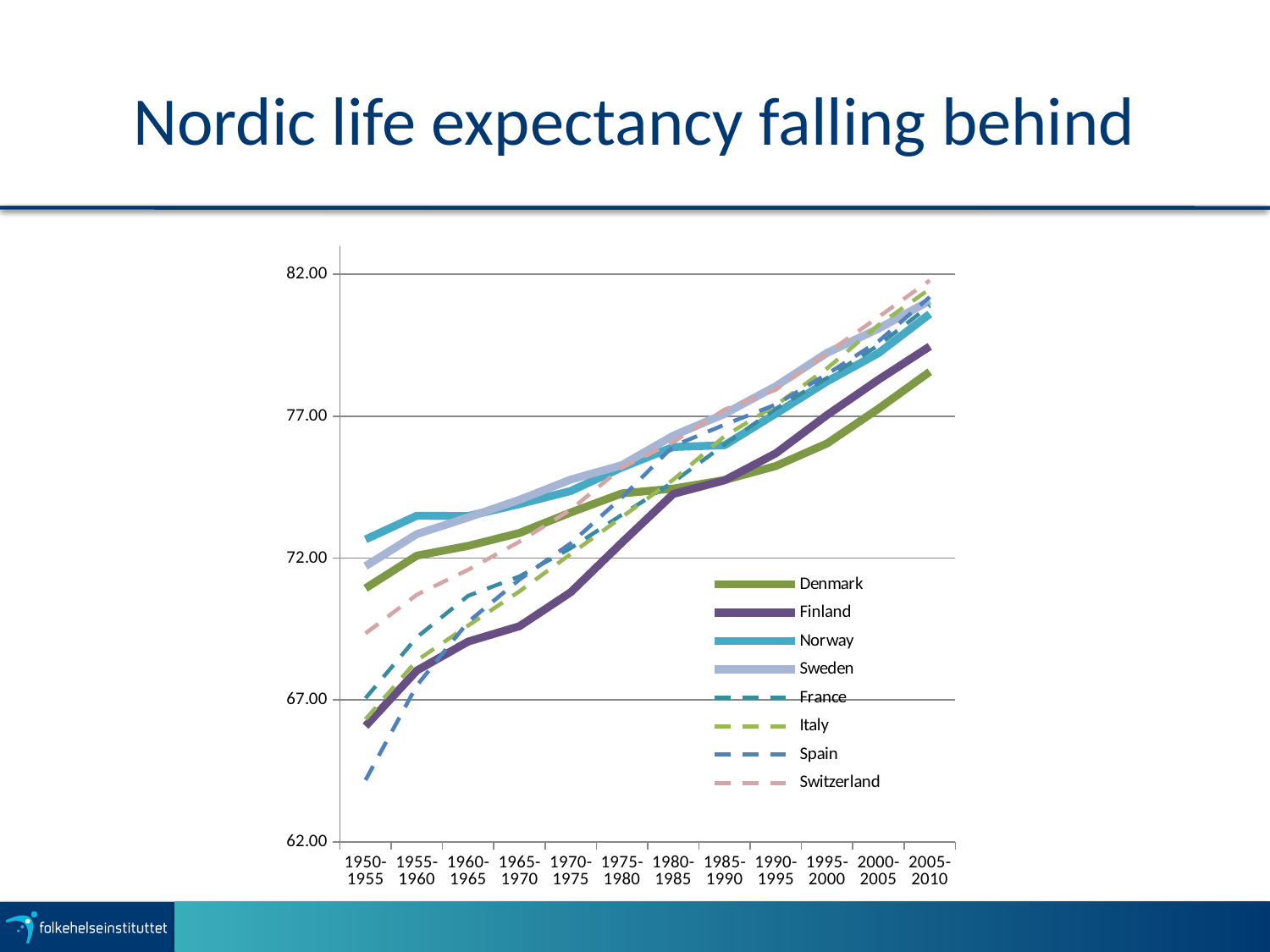
Which series are drawn with dashed lines? France, Italy, Spain, Switzerland Which country has the highest value in 1950-1955? Norway Is the value for Spain in 1950-1955 greater or less than 67.00? less In 1950-1955, which is larger, the value for Denmark or the value for Finland? Denmark How many time periods are shown along the x axis? 12 Does the value for Denmark rise or fall from 1950-1955 to 2005-2010? rise Which country has the lowest value in 2005-2010? Denmark Which country has the lowest value in 1950-1955? Spain How many series does the legend list? 8 What is the title of the slide? Nordic life expectancy falling behind Is the value for Denmark in 2005-2010 greater or less than 77.00? greater What kind of chart is shown on the slide? line chart